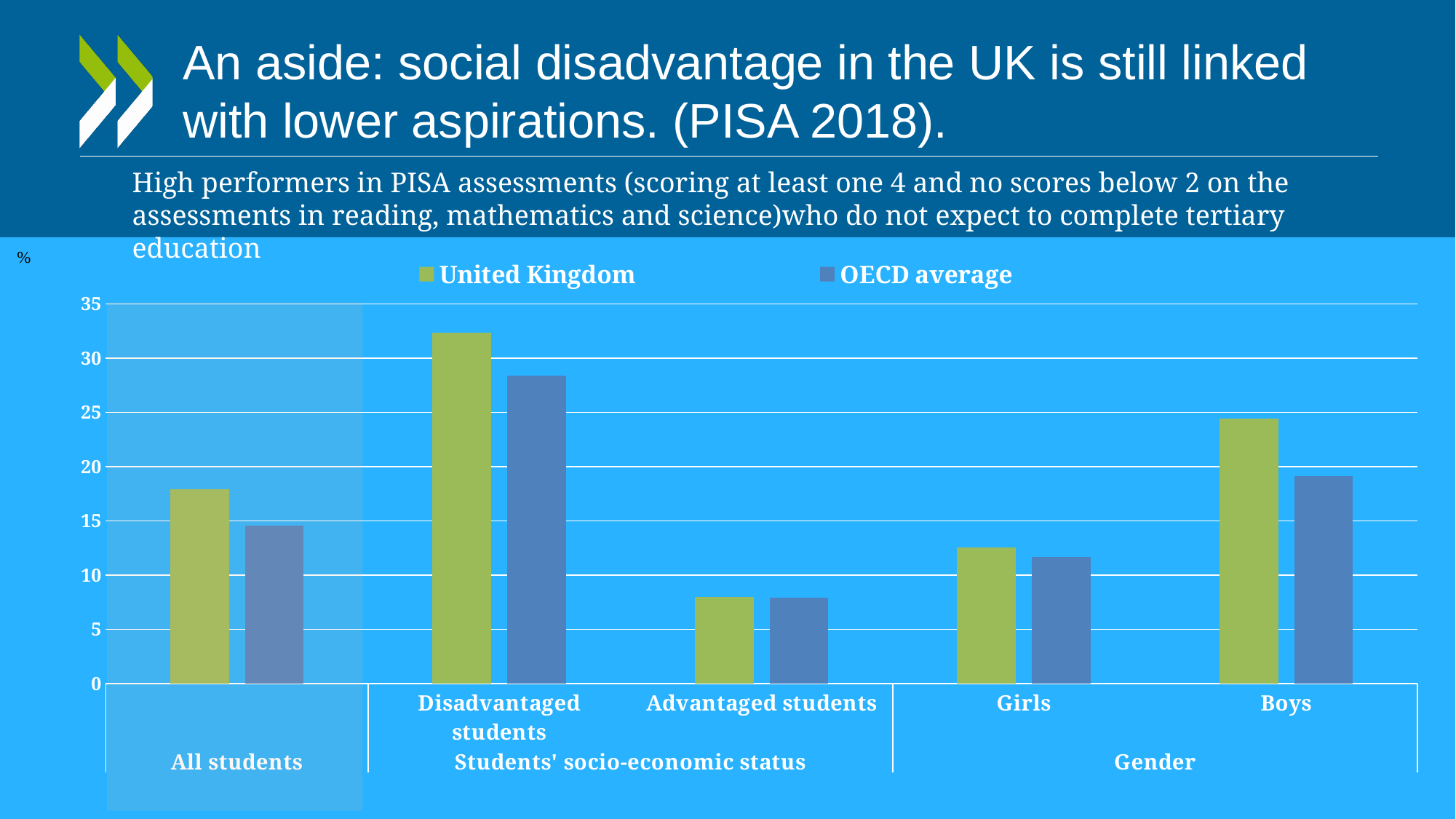
Is the United Kingdom value for Advantaged students greater or less than 10? less Which category has the highest value for the United Kingdom series? Disadvantaged students How many series does the legend list? 2 How many student categories are plotted along the x axis? 5 Which category has the highest value for the OECD average series? Disadvantaged students Is the United Kingdom value for Boys greater or less than 20? greater Is the United Kingdom value for Disadvantaged students greater or less than 30? greater For All students, which series has the larger value, United Kingdom or OECD average? United Kingdom What kind of chart is shown on the slide? bar chart What colour are the bars for the United Kingdom series? green Which category has the lowest value for the United Kingdom series? Advantaged students